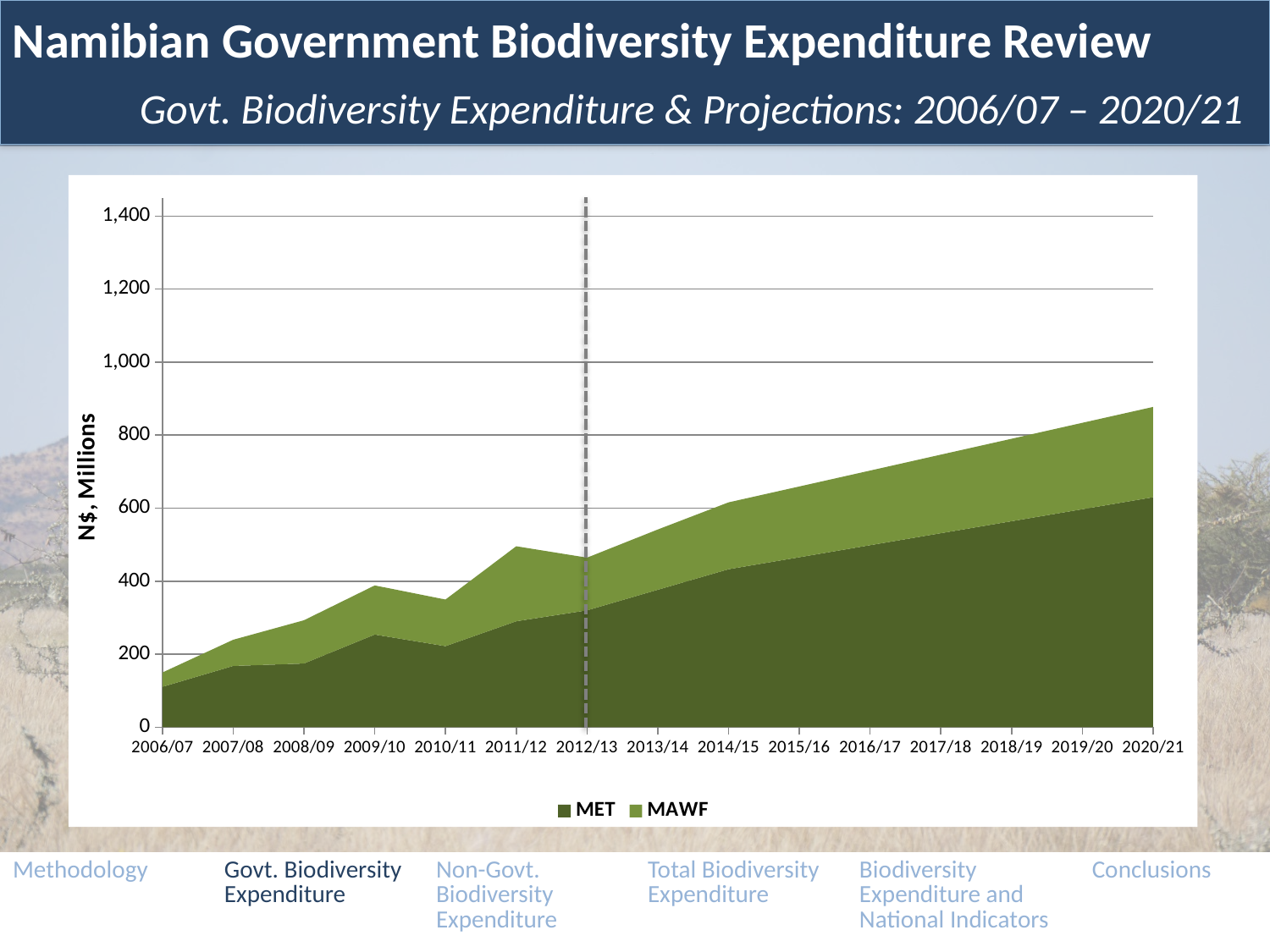
How many series does the legend list? 2 How many fiscal years are shown along the x axis? 15 In which year is the total (MET plus MAWF) expenditure lowest? 2006/07 What kind of chart is shown on the slide? Stacked area chart Is the total (MET plus MAWF) value for 2006/07 greater or less than 200? less In 2020/21, which series contributes more, MET or MAWF? MET Does the total government biodiversity expenditure generally rise or fall from 2006/07 to 2020/21? Rise What is the label of the y axis? N$, Millions Is the total (MET plus MAWF) value for 2020/21 greater or less than 800? greater Which series are listed in the legend? MET and MAWF Is the MET value for 2020/21 greater or less than 600? greater In which year is the total (MET plus MAWF) expenditure highest? 2020/21